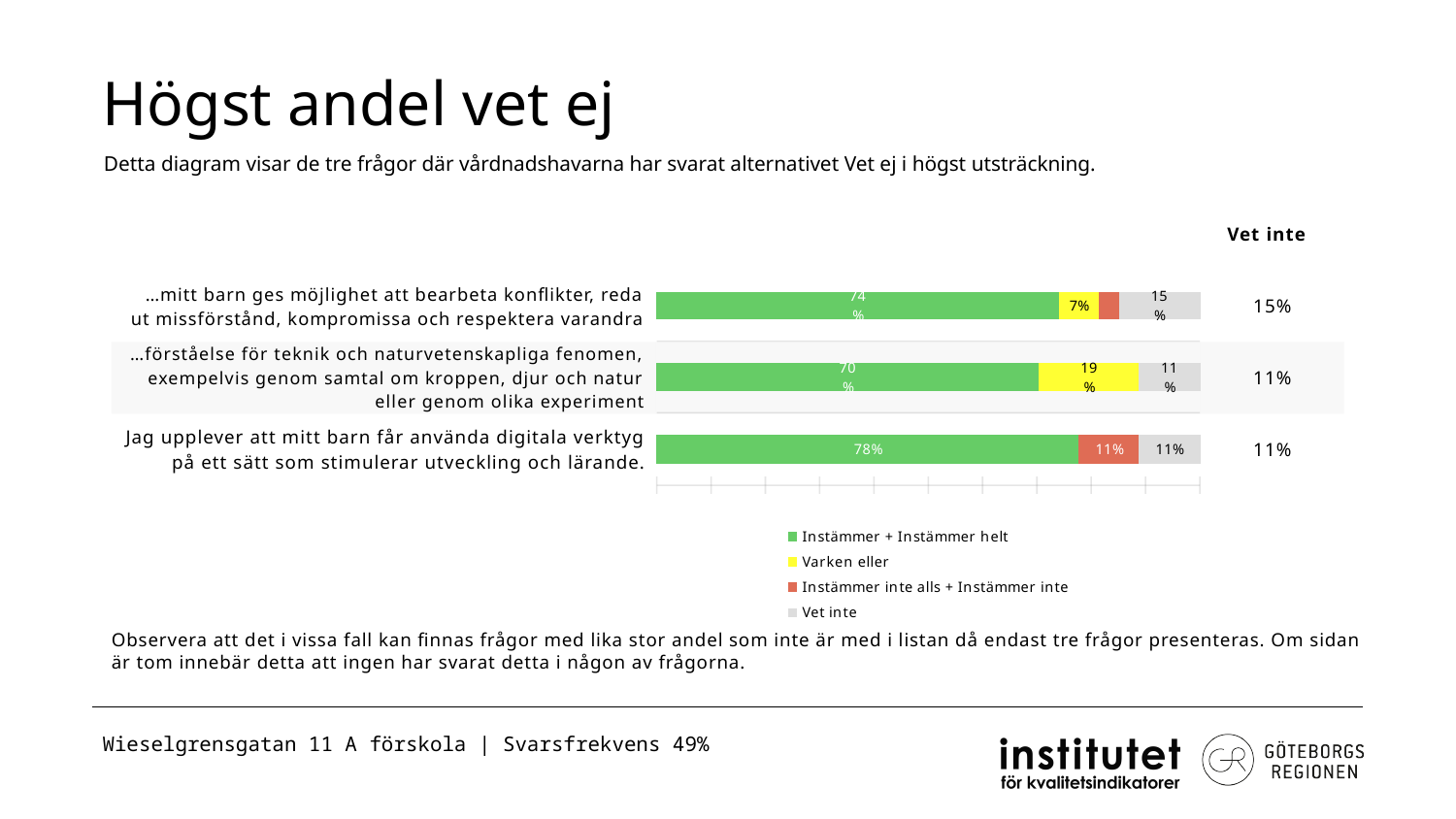
What is the 'Varken eller' share for '…förståelse för teknik och naturvetenskapliga fenomen, exempelvis genom samtal om kroppen, djur och natur eller genom olika experiment'? 19% Which is larger: the 'Varken eller' share for the technology/science question or for the digital tools question? the technology/science question What kind of chart is shown on the slide? stacked bar chart Which legend entry is shown in grey? Vet inte Which question has the highest 'Vet inte' share? …mitt barn ges möjlighet att bearbeta konflikter, reda ut missförstånd, kompromissa och respektera varandra How many series does the legend list? 4 What is the 'Varken eller' share for '…mitt barn ges möjlighet att bearbeta konflikter, reda ut missförstånd, kompromissa och respektera varandra'? 7% What is the 'Instämmer + Instämmer helt' share for 'Jag upplever att mitt barn får använda digitala verktyg på ett sätt som stimulerar utveckling och lärande.'? 78% What is the difference between the 'Instämmer + Instämmer helt' share for the digital tools question (78%) and the technology/science question (70%)? 8 percentage points Which question has the lowest 'Instämmer + Instämmer helt' share? …förståelse för teknik och naturvetenskapliga fenomen, exempelvis genom samtal om kroppen, djur och natur eller genom olika experiment What is the 'Vet inte' share for '…mitt barn ges möjlighet att bearbeta konflikter, reda ut missförstånd, kompromissa och respektera varandra'? 15% How many questions (categories) are shown in the chart? 3